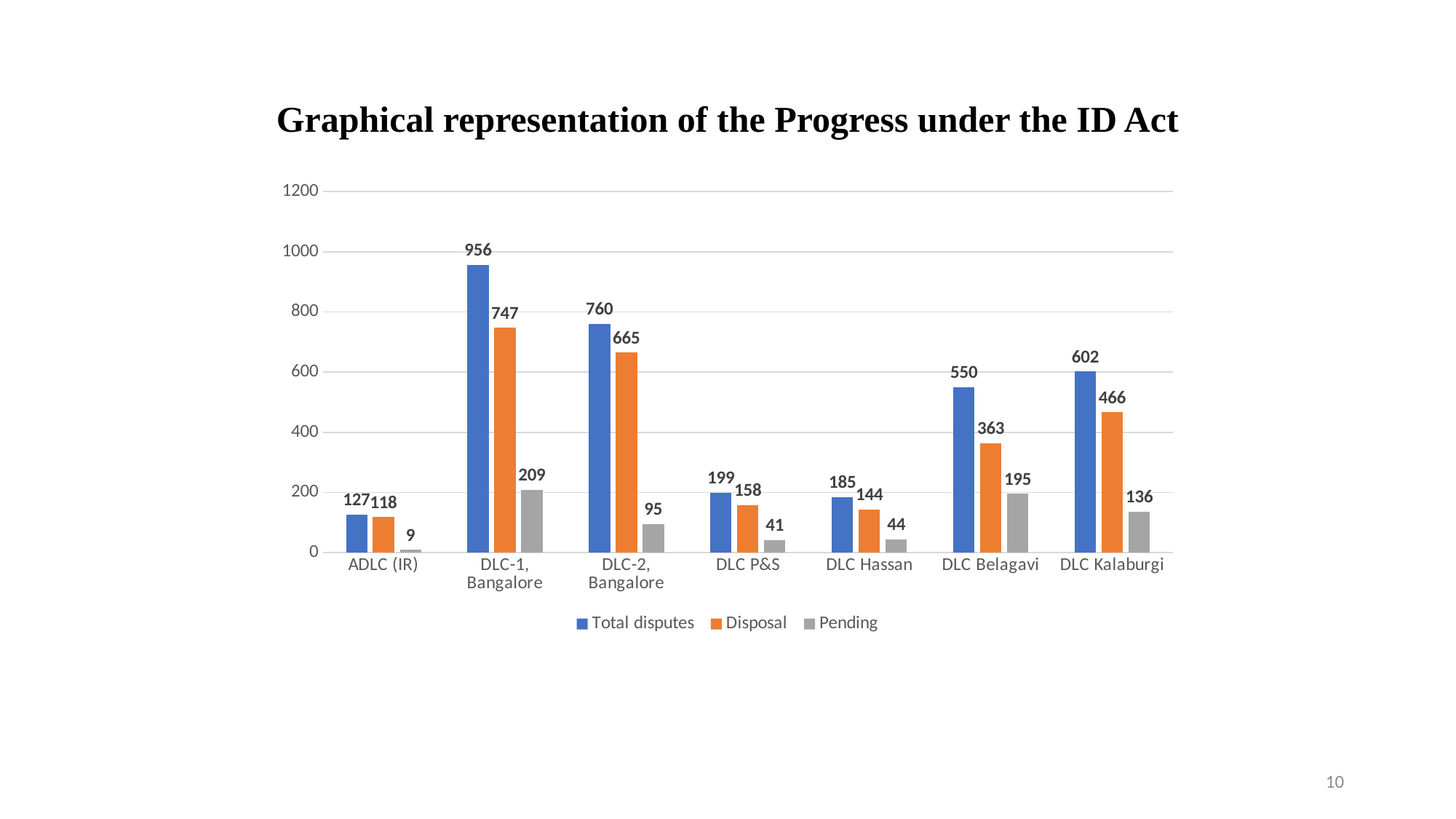
What is the value of Total disputes for DLC-1, Bangalore? 956 Which category has the highest Total disputes? DLC-1, Bangalore Is the Disposal value for DLC-2, Bangalore greater or less than 600? greater How many categories are shown on the x axis? 7 What is the Disposal value for DLC Belagavi? 363 What is the title of the chart? Graphical representation of the Progress under the ID Act How many series does the legend list? 3 Which category has the lowest Pending value? ADLC (IR) What kind of chart is shown on the slide? Bar chart What is the Pending value for ADLC (IR)? 9 Which is larger, the Pending value for DLC-1, Bangalore or for DLC Belagavi? DLC-1, Bangalore What is the difference between Total disputes and Disposal for DLC Kalaburgi? 136